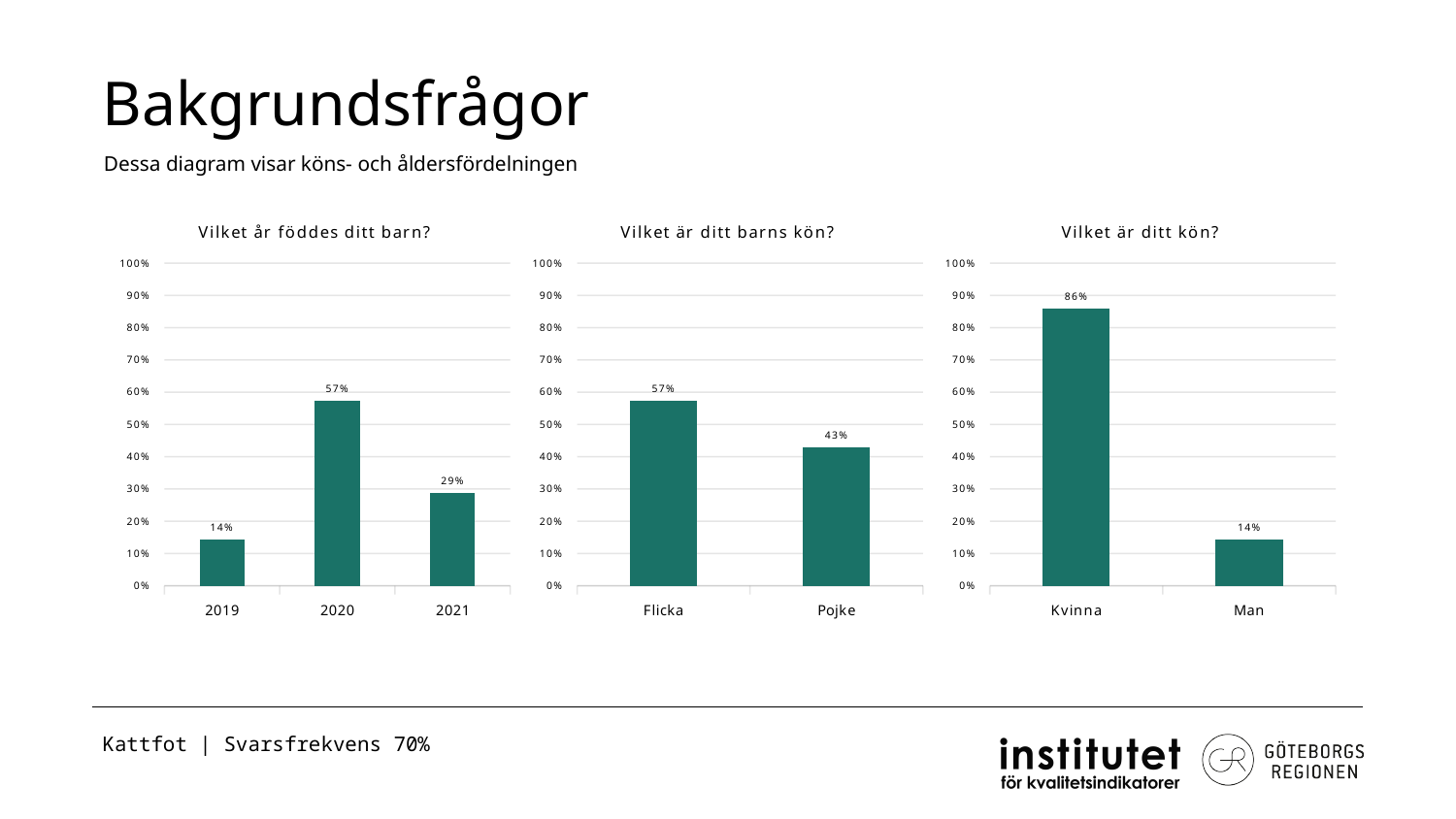
In the chart 'Vilket är ditt kön?', is the value for Man greater or less than 20%? less How many charts are shown on the slide? 3 In the chart 'Vilket är ditt barns kön?', what is the difference between Flicka and Pojke? 14% In the chart 'Vilket är ditt kön?', what is the value for Kvinna? 86% What kind of chart is 'Vilket är ditt kön?'? Bar chart How many categories are shown in the chart 'Vilket år föddes ditt barn?'? 3 In the chart 'Vilket är ditt barns kön?', what is the value for Pojke? 43% In the chart 'Vilket år föddes ditt barn?', which year has the lowest value? 2019 In the chart 'Vilket är ditt kön?', which is larger, Kvinna or Man? Kvinna In the chart 'Vilket år föddes ditt barn?', what is the difference between the values for 2020 and 2021? 28% In the chart 'Vilket år föddes ditt barn?', what is the value for 2020? 57% In the chart 'Vilket är ditt barns kön?', which category has the highest value? Flicka